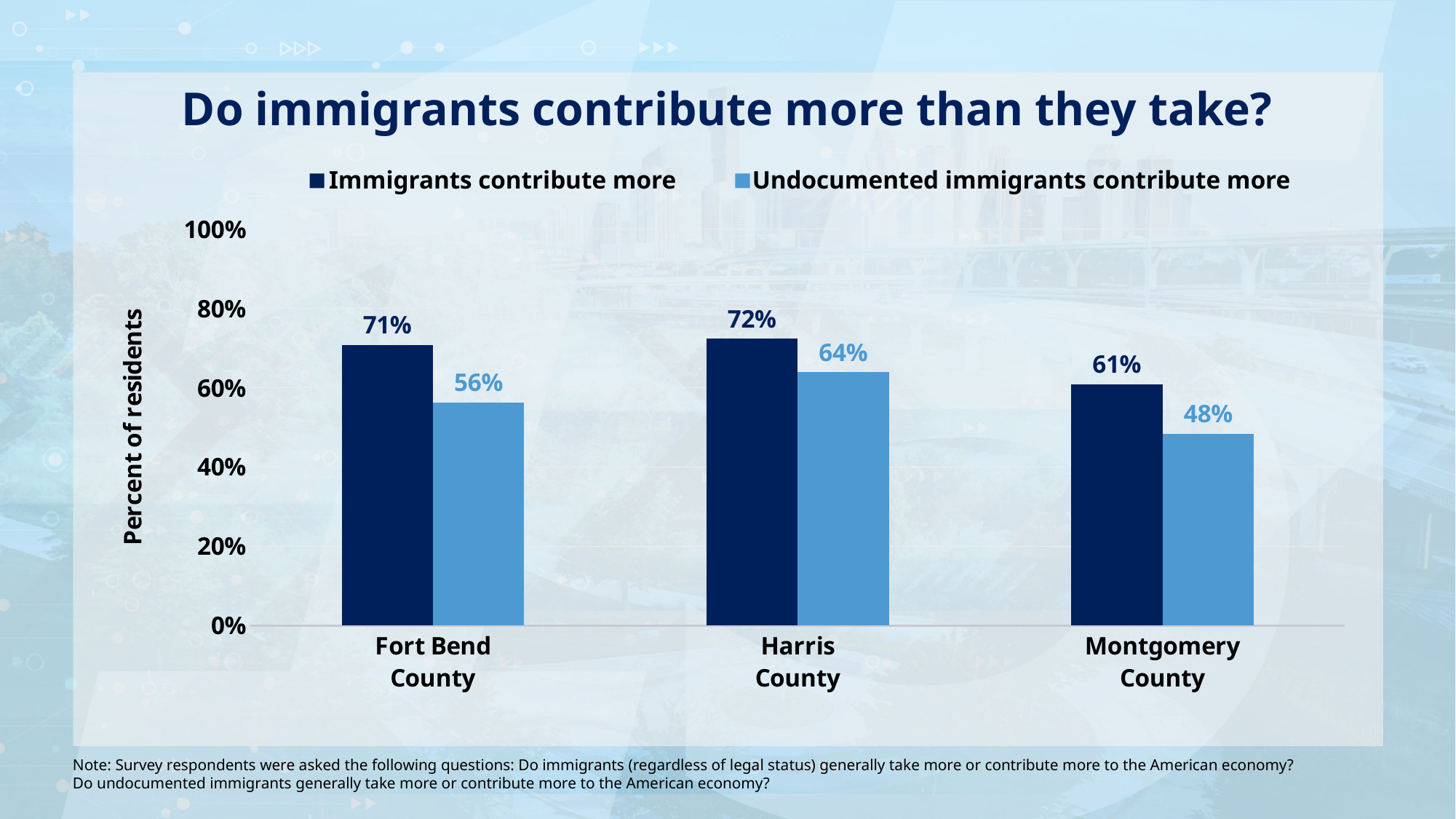
Which county has the highest value for 'Undocumented immigrants contribute more'? Harris County What percent of Harris County residents say undocumented immigrants contribute more? 64% What is the difference between Harris County and Montgomery County in the 'Undocumented immigrants contribute more' series? 16% How many series does the legend list? 2 What is the value for Montgomery County in the 'Immigrants contribute more' series? 61% What percent of Fort Bend County residents say immigrants contribute more? 71% What kind of chart is shown on the slide? Bar chart How many counties are shown on the x axis? 3 Which is larger: the 'Immigrants contribute more' value for Fort Bend County or for Harris County? Harris County What is the difference between the 'Immigrants contribute more' and 'Undocumented immigrants contribute more' values for Fort Bend County? 15% Is the 'Undocumented immigrants contribute more' value for Montgomery County greater or less than 60%? less Which county has the lowest value for 'Immigrants contribute more'? Montgomery County